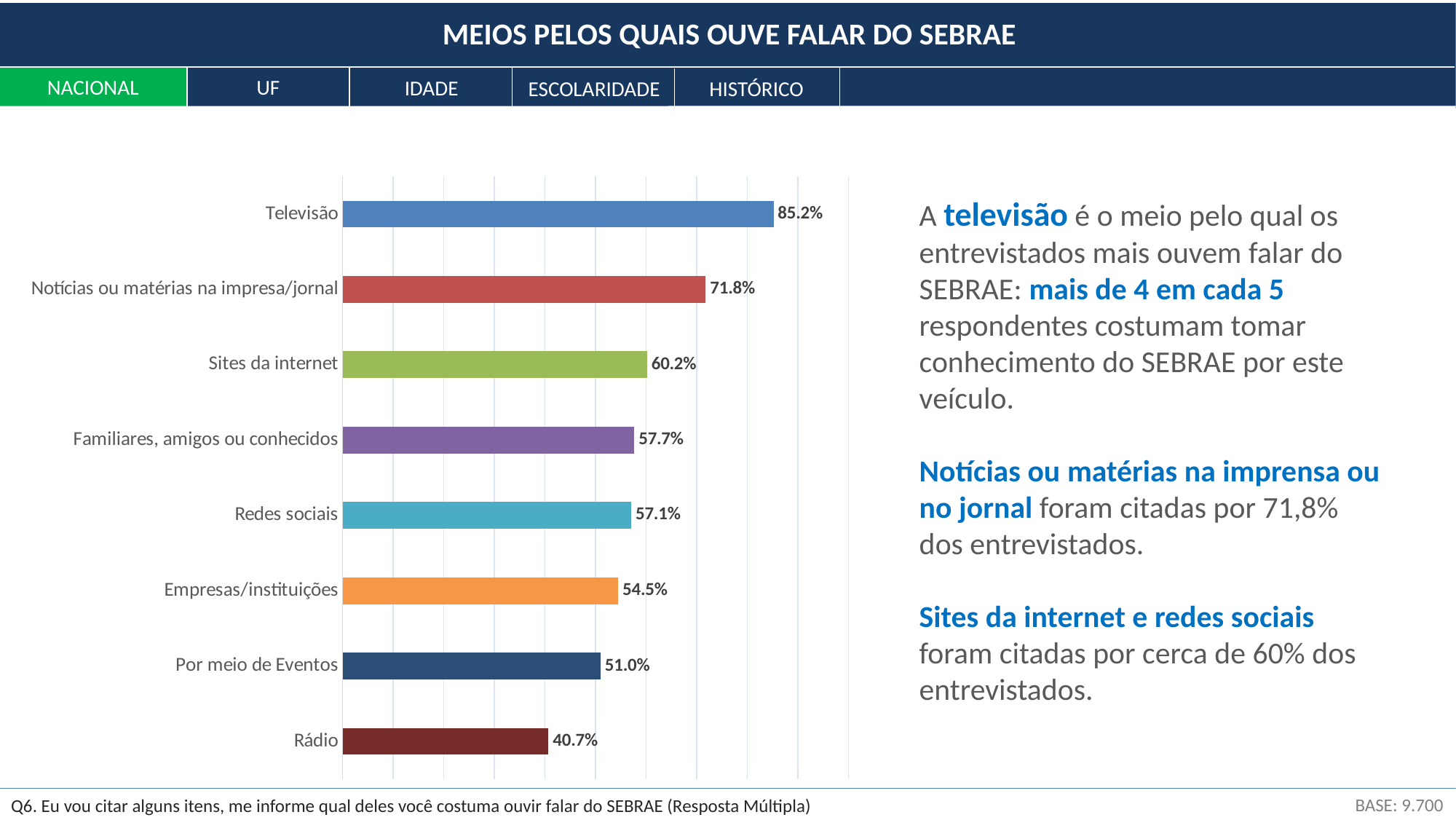
What is the value for Televisão? 85.2% How many categories are shown in the chart? 8 What is the difference between the values for Televisão and Rádio? 44.5% Which is larger, the value for Empresas/instituições or the value for Por meio de Eventos? Empresas/instituições What kind of chart is shown on the slide? Bar chart What is the value for Redes sociais? 57.1% Which category has the lowest value? Rádio What is the title of the slide? MEIOS PELOS QUAIS OUVE FALAR DO SEBRAE Which category has the highest value? Televisão What is the value for Por meio de Eventos? 51.0% What is the value for Rádio? 40.7% What is the difference between the values for Notícias ou matérias na impresa/jornal and Sites da internet? 11.6%